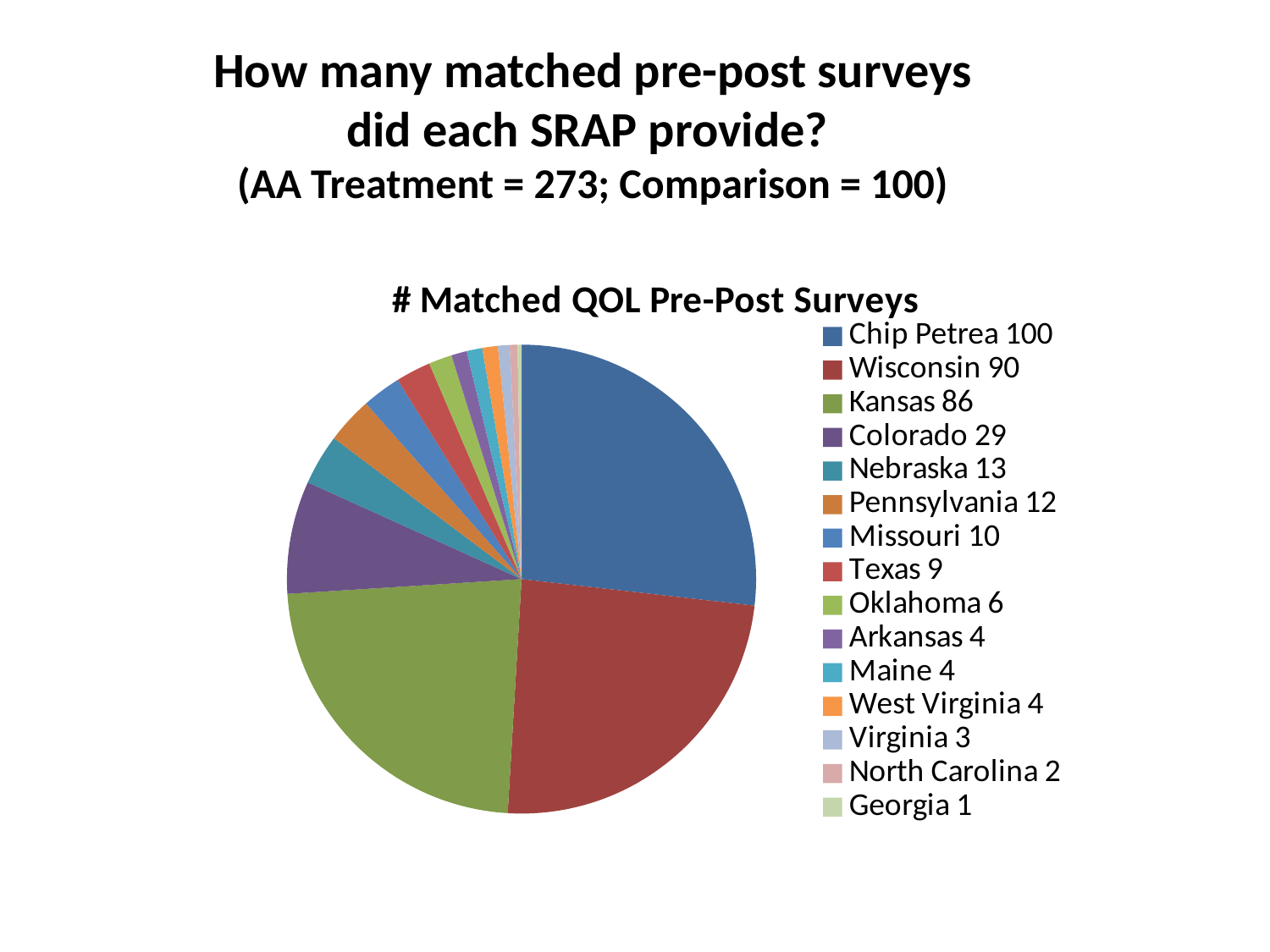
How many matched QOL pre-post surveys did Colorado provide? 29 How many matched QOL pre-post surveys did Pennsylvania provide? 12 Which SRAP provided the fewest matched QOL pre-post surveys? Georgia Which provided more matched surveys, Colorado or Nebraska? Colorado What is the difference between the number of surveys from Wisconsin and from Kansas? 4 How many matched QOL pre-post surveys did Oklahoma provide? 6 How many matched QOL pre-post surveys did Wisconsin provide? 90 Which SRAP provided the most matched QOL pre-post surveys? Chip Petrea How many SRAPs (slices) are shown in the pie chart? 15 What is the title of the chart? # Matched QOL Pre-Post Surveys What is the difference between the number of surveys from Chip Petrea and from Missouri? 90 What kind of chart is shown on the slide? pie chart